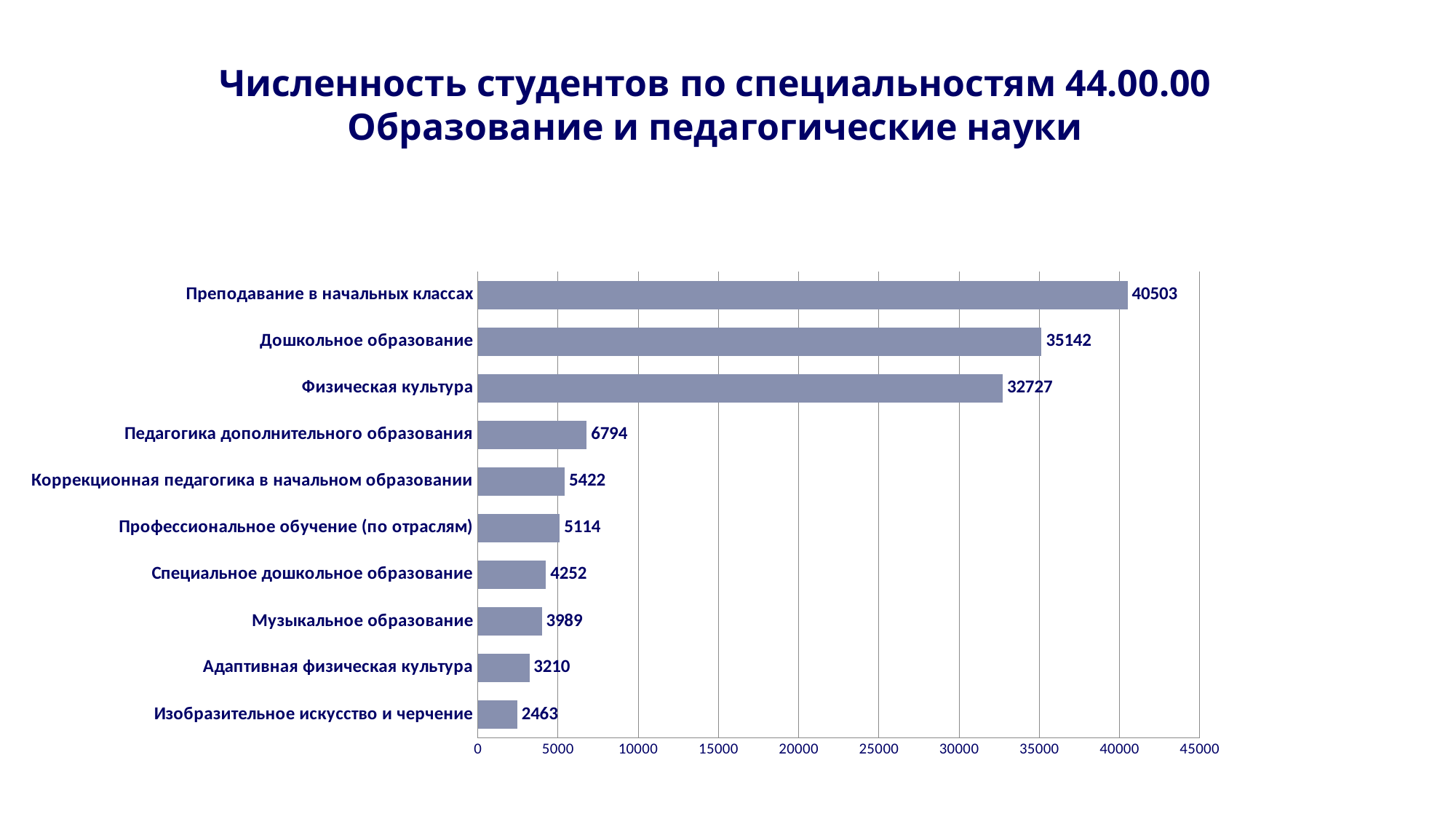
What is the value for Музыкальное образование? 3989 Which category has the lowest value? Изобразительное искусство и черчение How many categories are shown in the chart? 10 What is the value for Физическая культура? 32727 Which is larger: Специальное дошкольное образование or Адаптивная физическая культура? Специальное дошкольное образование What is the difference between Дошкольное образование and Физическая культура? 2415 What is the value for Преподавание в начальных классах? 40503 What is the difference between Педагогика дополнительного образования and Коррекционная педагогика в начальном образовании? 1372 What is the title of the chart? Численность студентов по специальностям 44.00.00 Образование и педагогические науки Which category has the highest value? Преподавание в начальных классах Is the value for Дошкольное образование greater or less than 30000? greater What kind of chart is shown on the slide? Bar chart